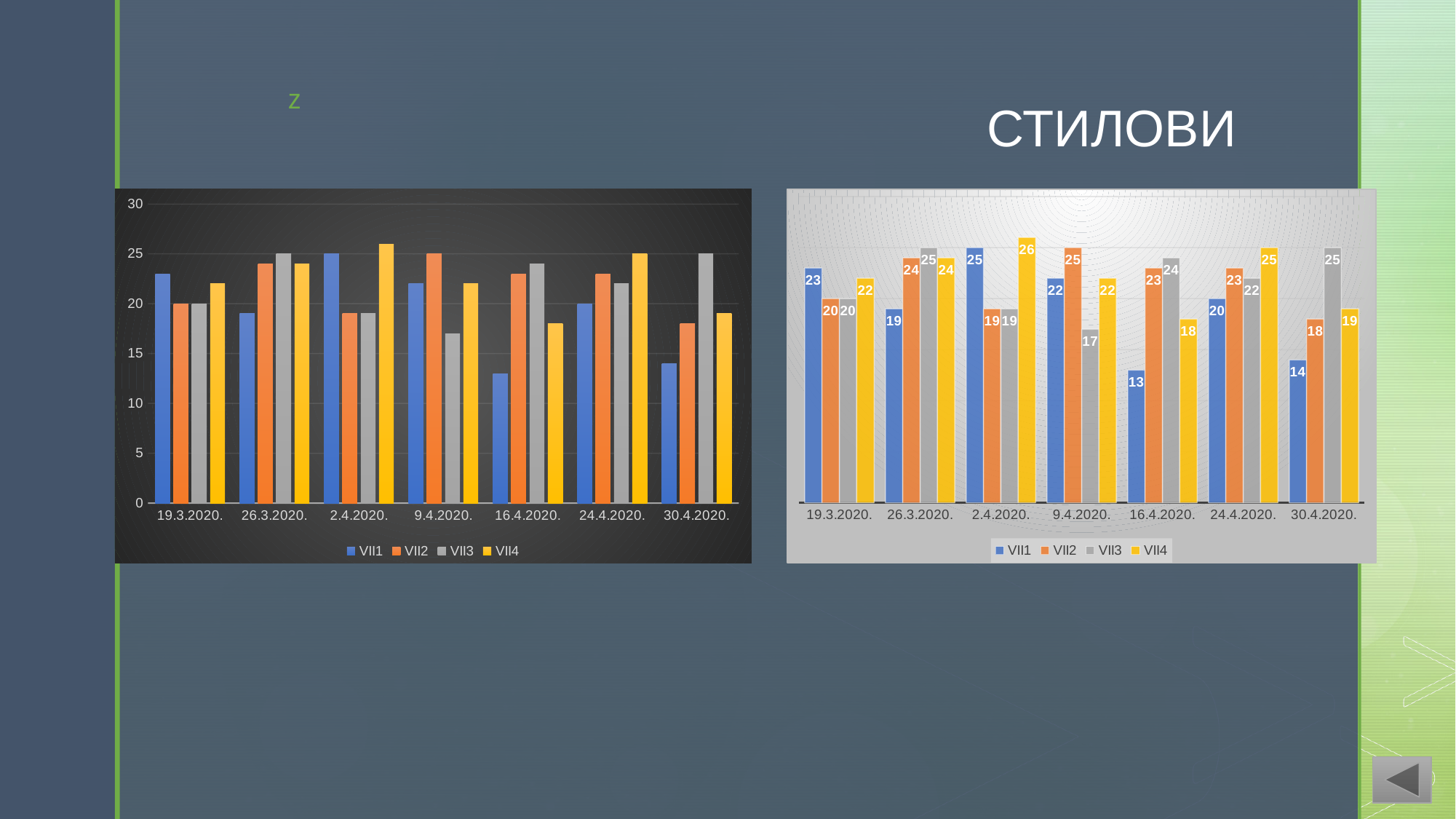
On the left chart, is the value for VII1 on 16.4.2020. greater or less than 15? less On the left chart, is the value for VII4 on 2.4.2020. greater or less than 25? greater On the right chart, which series has the lowest value on 30.4.2020.? VII1 On the right chart, what is the difference between VII3 and VII1 on 16.4.2020.? 11 On the right chart, which series has the highest value on 9.4.2020.? VII2 What kind of chart is the left chart? bar chart How many date categories are shown on the x axis of the left chart? 7 How many series does the legend of the right chart list? 4 On the right chart, what is the value for VII4 on 2.4.2020.? 26 On the right chart, what is the value for VII3 on 30.4.2020.? 25 On the right chart, which is larger on 26.3.2020., VII1 or VII3? VII3 On the right chart, what is the value for VII1 on 16.4.2020.? 13